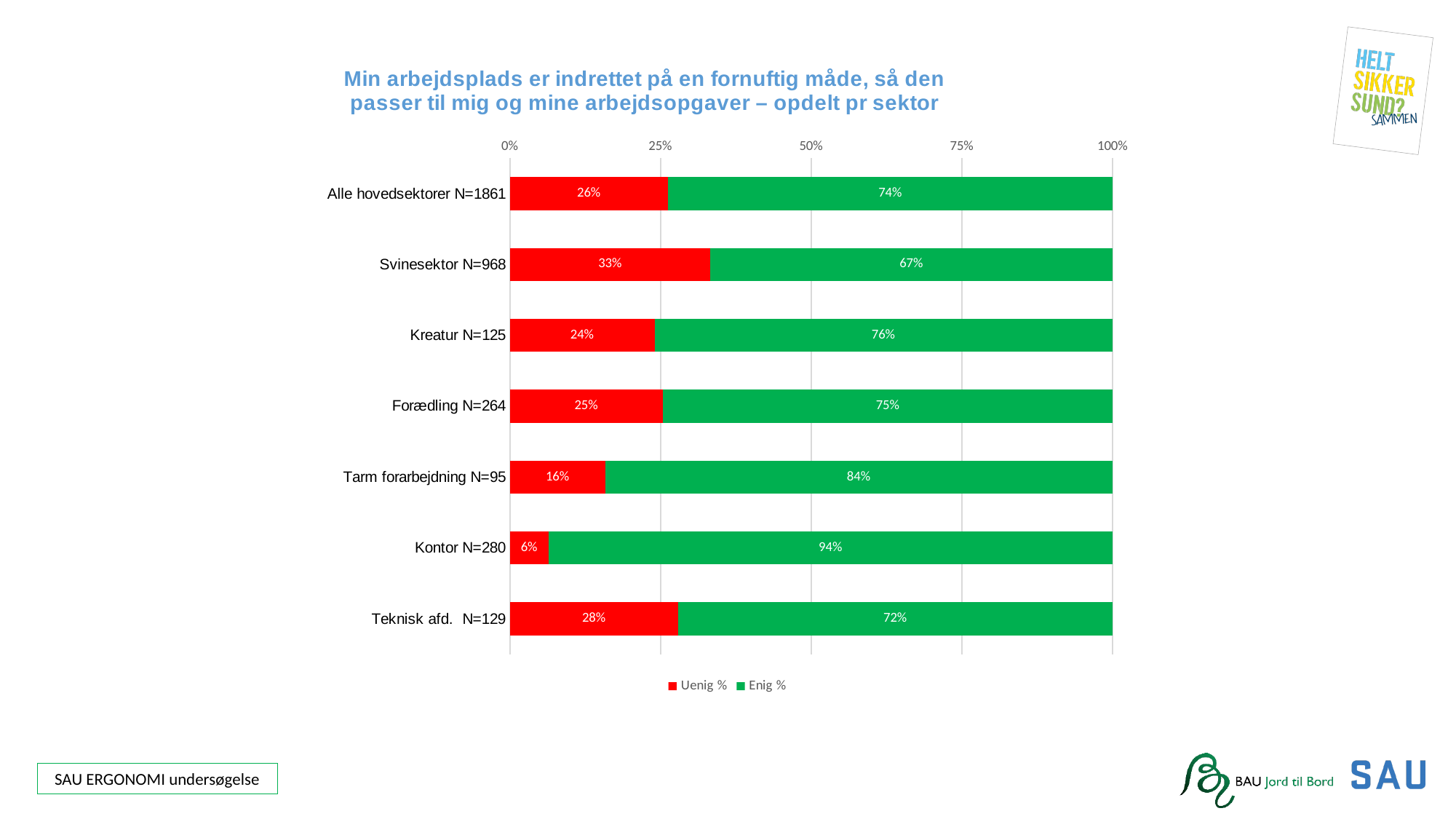
What is the Enig % value for Kontor N=280? 94% Which has a larger Uenig % value, Kreatur N=125 or Forædling N=264? Forædling N=264 How many categories are shown on the chart? 7 Which category has the highest Uenig % value? Svinesektor N=968 What is the Uenig % value for Svinesektor N=968? 33% Which category has the lowest Enig % value? Svinesektor N=968 What colour represents the Enig % series? Green Is the Enig % value for Alle hovedsektorer N=1861 greater or less than 50%? greater How many series does the legend list? 2 What is the Enig % value for Tarm forarbejdning N=95? 84% What kind of chart is shown on the slide? Stacked bar chart What is the difference between the Enig % values for Kontor N=280 and Teknisk afd. N=129? 22%